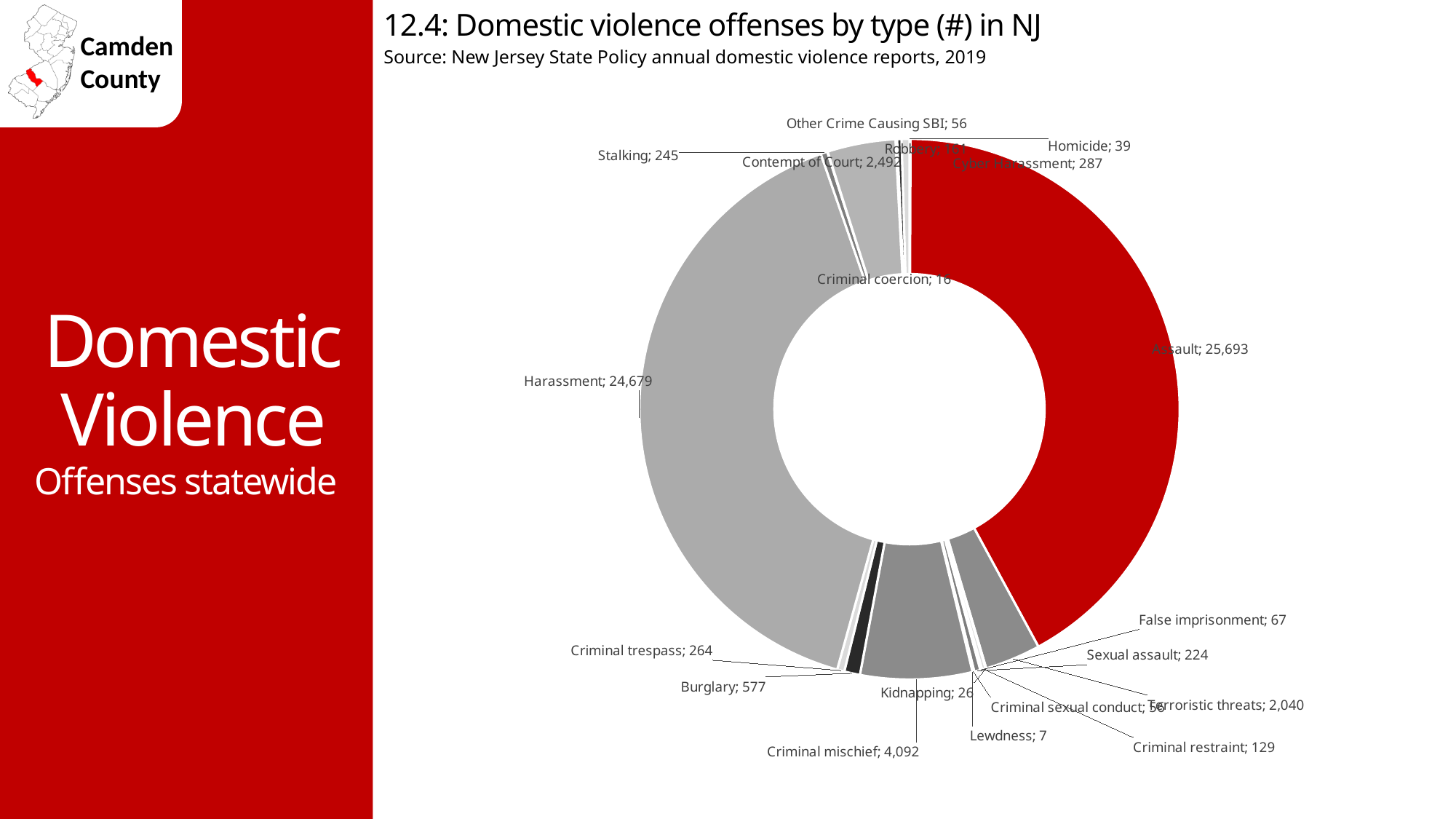
What is the difference between Burglary and Criminal trespass offenses? 313 Which offense type has the highest number of offenses? Assault What kind of chart is shown on the slide? Doughnut (pie) chart What is the title of the chart? 12.4: Domestic violence offenses by type (#) in NJ What is the number of Stalking offenses? 245 Which is larger: Contempt of Court or Terroristic threats? Contempt of Court Which offense type has the lowest number of offenses? Lewdness What colour is the Assault slice of the chart? Red How many more Assault offenses are there than Harassment offenses? 1,014 What is the number of Criminal mischief offenses? 4,092 What is the number of Assault offenses shown on the chart? 25,693 What is the number of Harassment offenses shown on the chart? 24,679